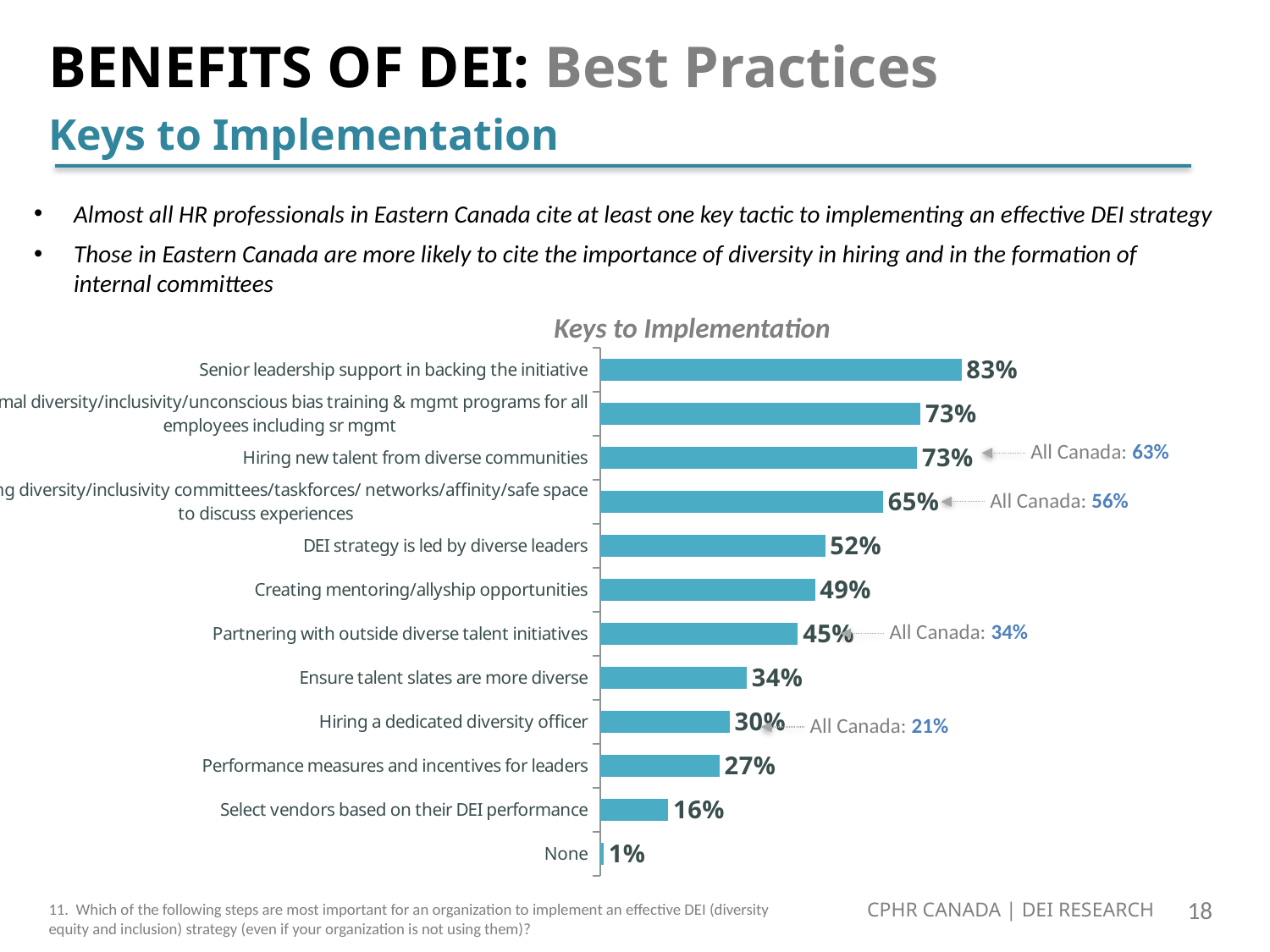
Which is larger: "Ensure talent slates are more diverse" or "Hiring a dedicated diversity officer"? Ensure talent slates are more diverse What is the value for "Hiring new talent from diverse communities"? 73% What kind of chart is shown on the slide? Bar chart How many categories are plotted in the chart? 12 What is the value for "Senior leadership support in backing the initiative"? 83% Which category has the highest value? Senior leadership support in backing the initiative What is the value for "DEI strategy is led by diverse leaders"? 52% What is the value for "Select vendors based on their DEI performance"? 16% What is the All Canada value shown next to "Hiring a dedicated diversity officer"? 21% What is the difference between "Creating mentoring/allyship opportunities" and "Partnering with outside diverse talent initiatives"? 4% Which category has the lowest value? None What is the title of the chart? Keys to Implementation